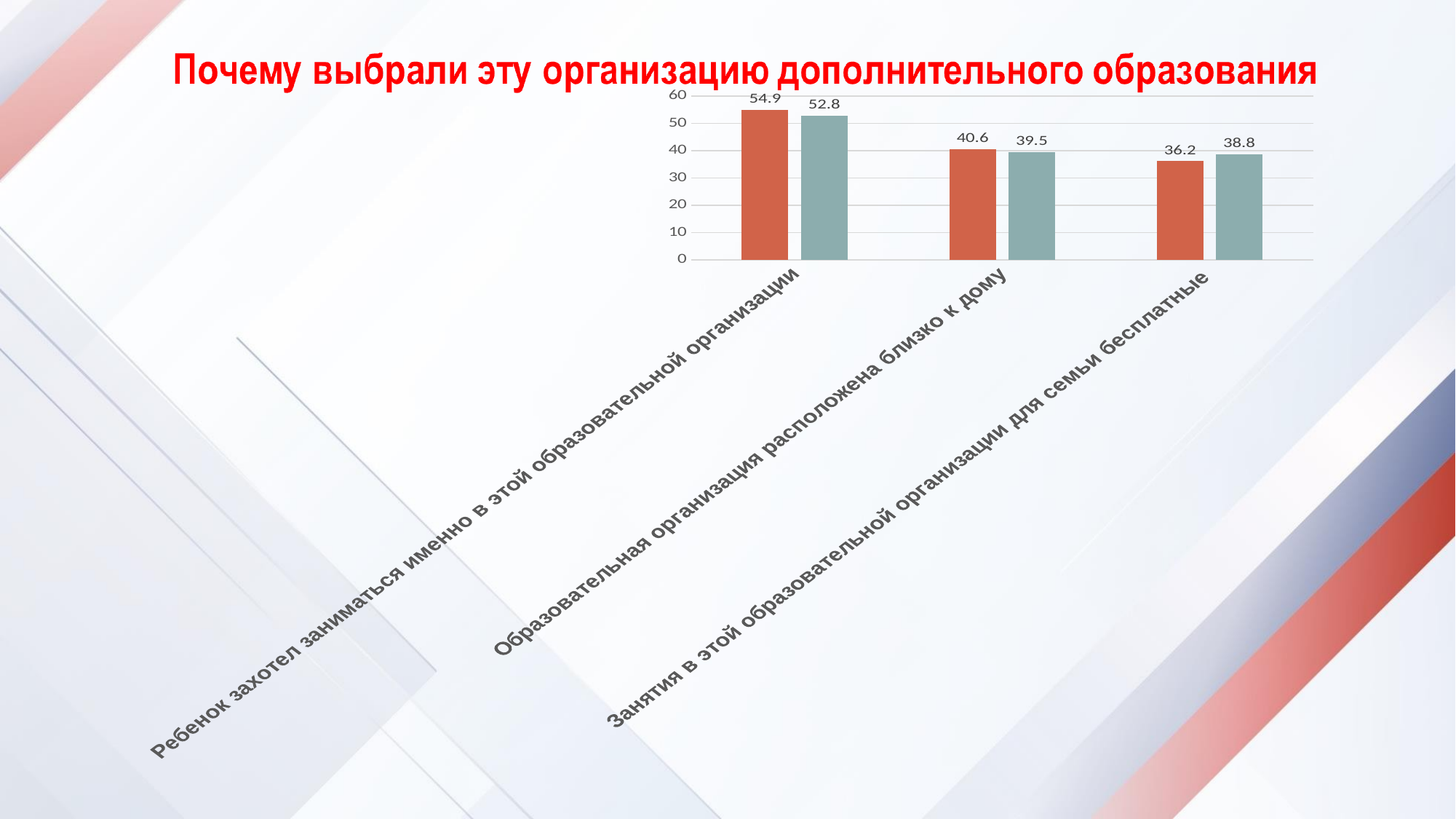
What is the value of the teal bar for "Ребенок захотел заниматься именно в этой образовательной организации"? 52.8 What is the value of the teal bar for "Занятия в этой образовательной организации для семьи бесплатные"? 38.8 What is the value of the orange bar for "Образовательная организация расположена близко к дому"? 40.6 Do the orange bar values rise or fall from left to right across the categories? fall What is the value of the orange bar for "Ребенок захотел заниматься именно в этой образовательной организации"? 54.9 How many categories are shown on the x axis of the chart? 3 Which category has the highest orange bar? Ребенок захотел заниматься именно в этой образовательной организации What is the difference between the orange and teal bars for "Образовательная организация расположена близко к дому"? 1.1 For "Занятия в этой образовательной организации для семьи бесплатные", which bar is larger, the orange or the teal one? teal Which category has the lowest orange bar? Занятия в этой образовательной организации для семьи бесплатные What kind of chart is shown on the slide? bar chart What is the title of the slide above the chart? Почему выбрали эту организацию дополнительного образования